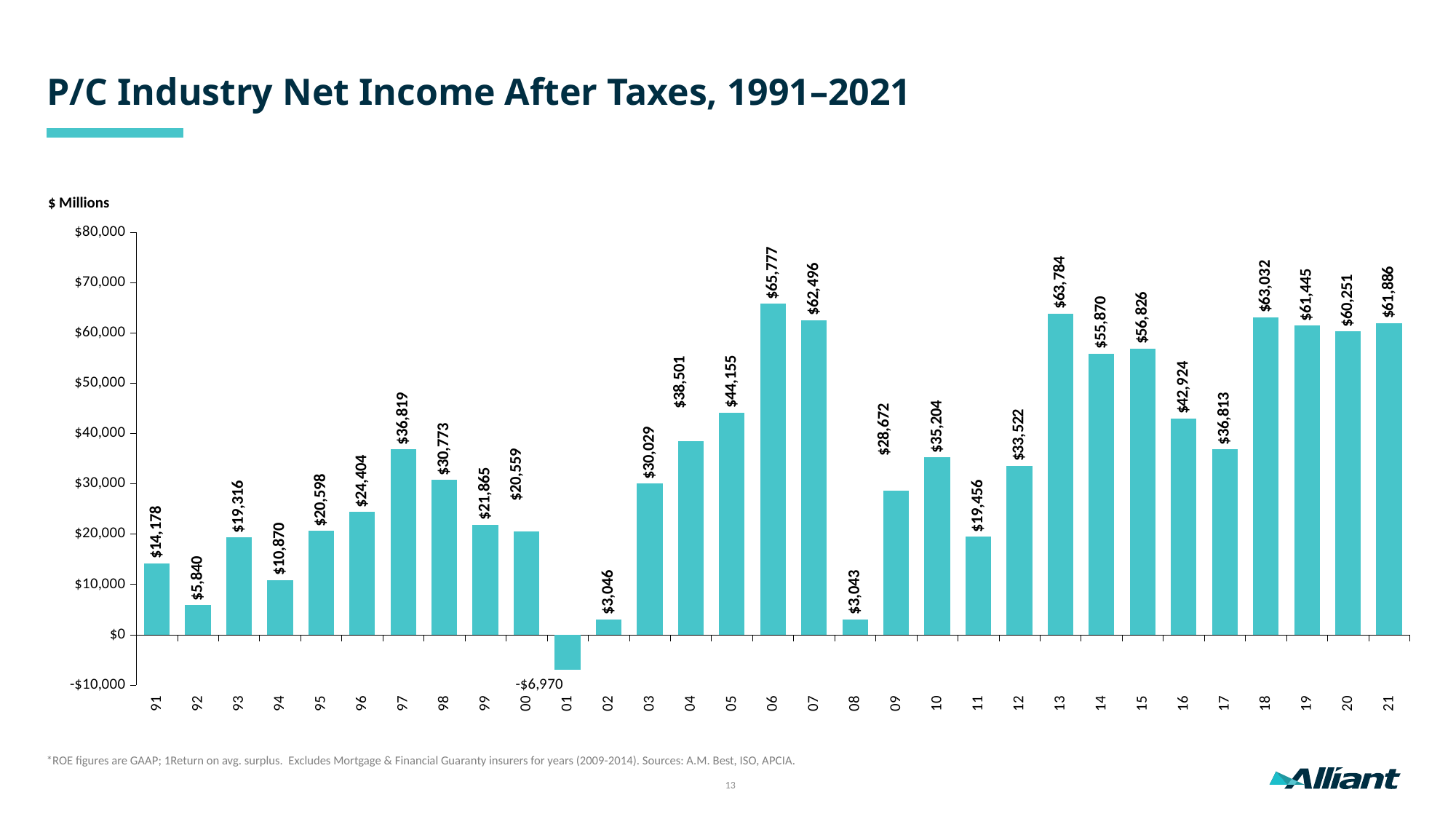
What is the difference between the values for 2021 and 2020? $1,635 How many years are plotted in the chart? 31 Which year has the highest net income after taxes? 06 Which year has the larger value, 2018 or 2019? 2018 What value is shown for 2001? -$6,970 What is the net income after taxes shown for 2021? $61,886 What kind of chart is shown on the slide? bar chart Do the values rise or fall from 2002 to 2006? rise What is the difference between the values for 2013 and 2012? $30,262 Is the value for 2009 greater or less than $30,000? less Which year has the lowest net income after taxes? 01 What is the P/C industry net income after taxes for 2006? $65,777